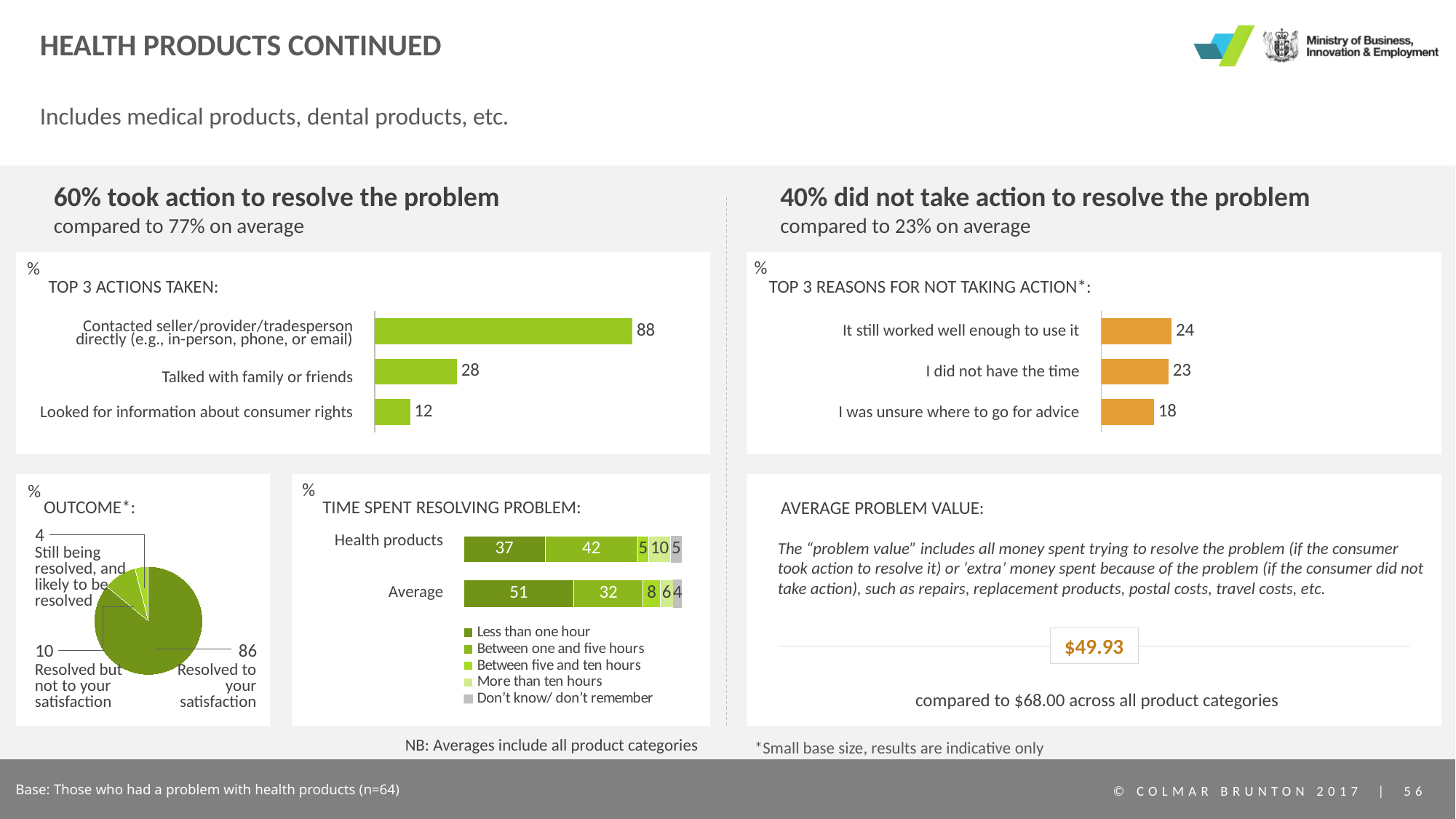
In the 'TIME SPENT RESOLVING PROBLEM' chart, what is the 'Less than one hour' value for 'Health products'? 37 In the 'TIME SPENT RESOLVING PROBLEM' chart, which is larger for 'Between one and five hours': 'Health products' or 'Average'? Health products In the 'OUTCOME' pie chart, what is the value for 'Resolved to your satisfaction'? 86 In the 'TOP 3 REASONS FOR NOT TAKING ACTION' chart, what is the difference between 'It still worked well enough to use it' and 'I was unsure where to go for advice'? 6 In the 'TOP 3 REASONS FOR NOT TAKING ACTION' chart, how many reasons are shown? 3 In the 'TOP 3 ACTIONS TAKEN' chart, what is the value for 'Contacted seller/provider/tradesperson directly'? 88 In the 'TOP 3 REASONS FOR NOT TAKING ACTION' chart, which reason has the highest value? It still worked well enough to use it In the 'TOP 3 REASONS FOR NOT TAKING ACTION' chart, what is the value for 'I did not have the time'? 23 In the 'TOP 3 ACTIONS TAKEN' chart, what is the difference between 'Contacted seller/provider/tradesperson directly' and 'Talked with family or friends'? 60 In the 'TOP 3 ACTIONS TAKEN' chart, which action has the lowest value? Looked for information about consumer rights What kind of chart is the 'OUTCOME' chart? Pie chart In the 'TIME SPENT RESOLVING PROBLEM' chart, how many series does the legend list? 5